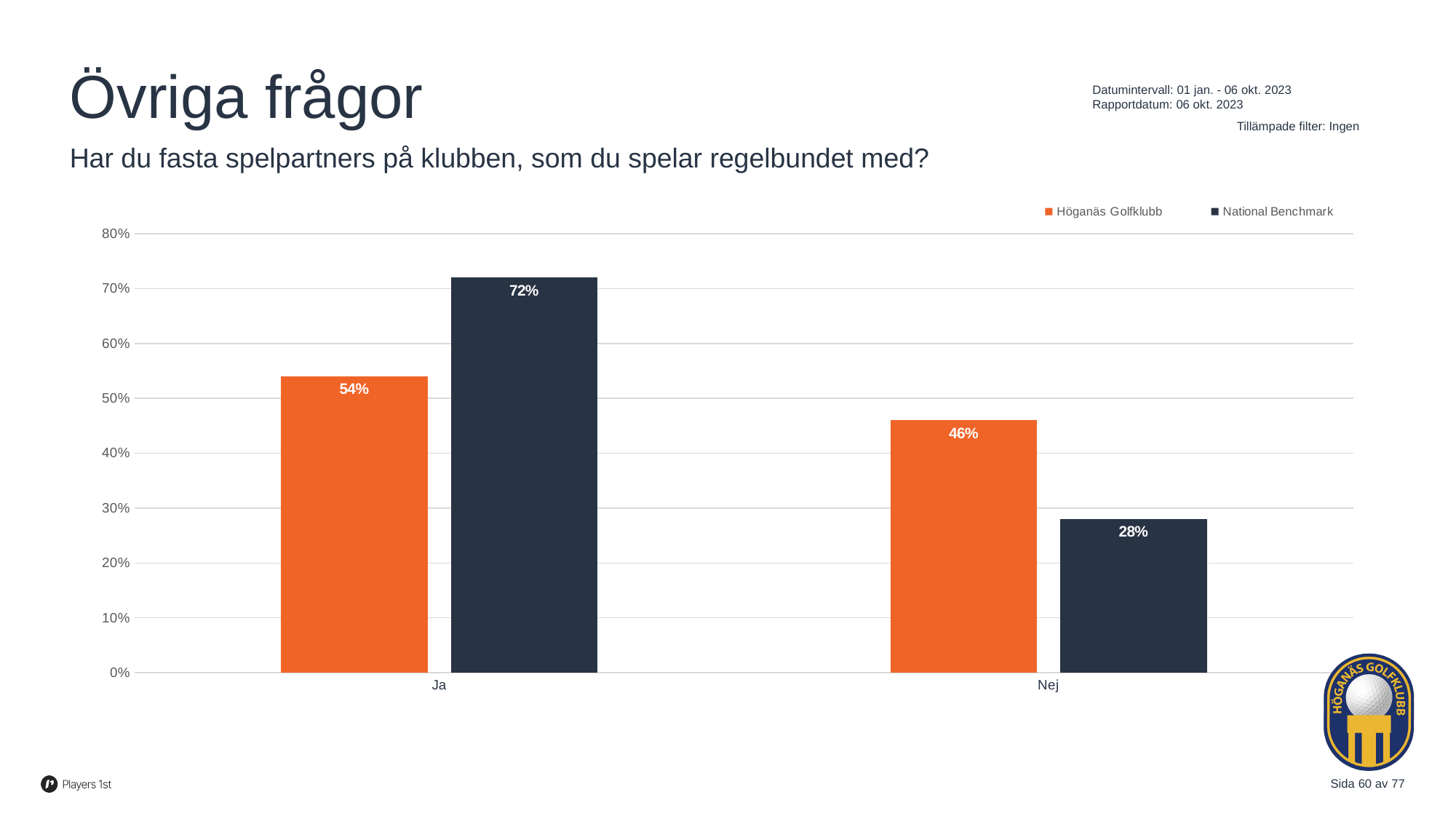
How many categories are shown on the x axis? 2 Is the National Benchmark value for Nej greater or less than 30%? less What is the difference between the National Benchmark and Höganäs Golfklubb values for Ja? 18% What is the value for National Benchmark for the category Ja? 72% How many series does the legend list? 2 Which category has the highest National Benchmark value? Ja What is the value for Höganäs Golfklubb for the category Ja? 54% Which category has the lowest Höganäs Golfklubb value? Nej What kind of chart is shown on the slide? Bar chart For the category Nej, which series has the larger value, Höganäs Golfklubb or National Benchmark? Höganäs Golfklubb What is the value for National Benchmark for the category Nej? 28% What is the value for Höganäs Golfklubb for the category Nej? 46%